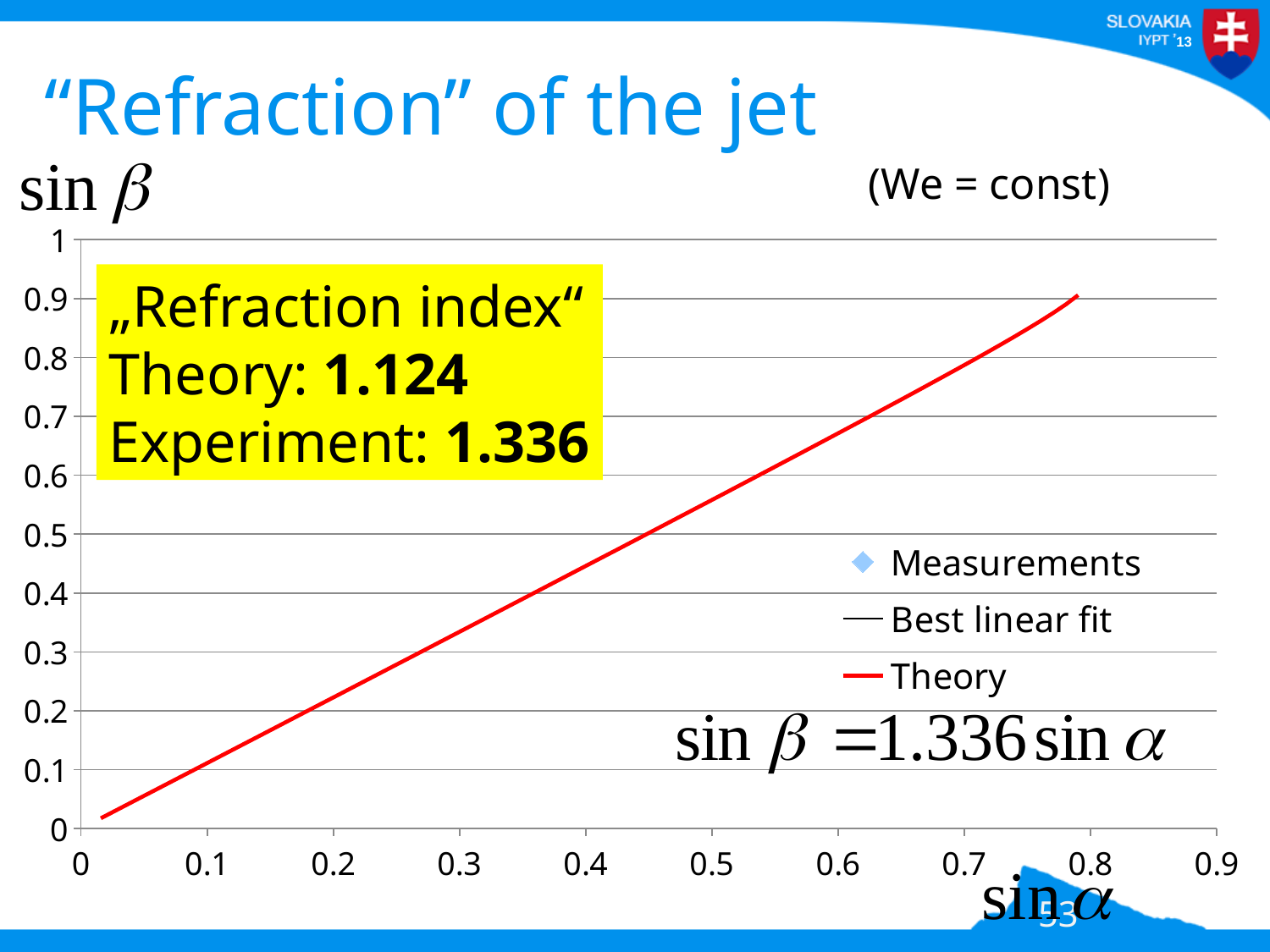
Is the value of the Theory line at sin α = 0.7 greater or less than 0.9? less What is the highest tick value shown on the x axis (sin α)? 0.9 How many series does the legend list? 3 What is the highest tick value shown on the y axis (sin β)? 1 What is the title of the slide containing the chart? "Refraction" of the jet Is the value of the Theory line at sin α = 0.3 greater or less than 0.3? greater Is the value of the Theory line at sin α = 0.5 greater or less than 0.5? greater How many tick labels are shown on the x axis? 10 Does the Theory line rise or fall as sin α increases? rises Which series is drawn as a red line? Theory What kind of chart is shown on the slide? line chart